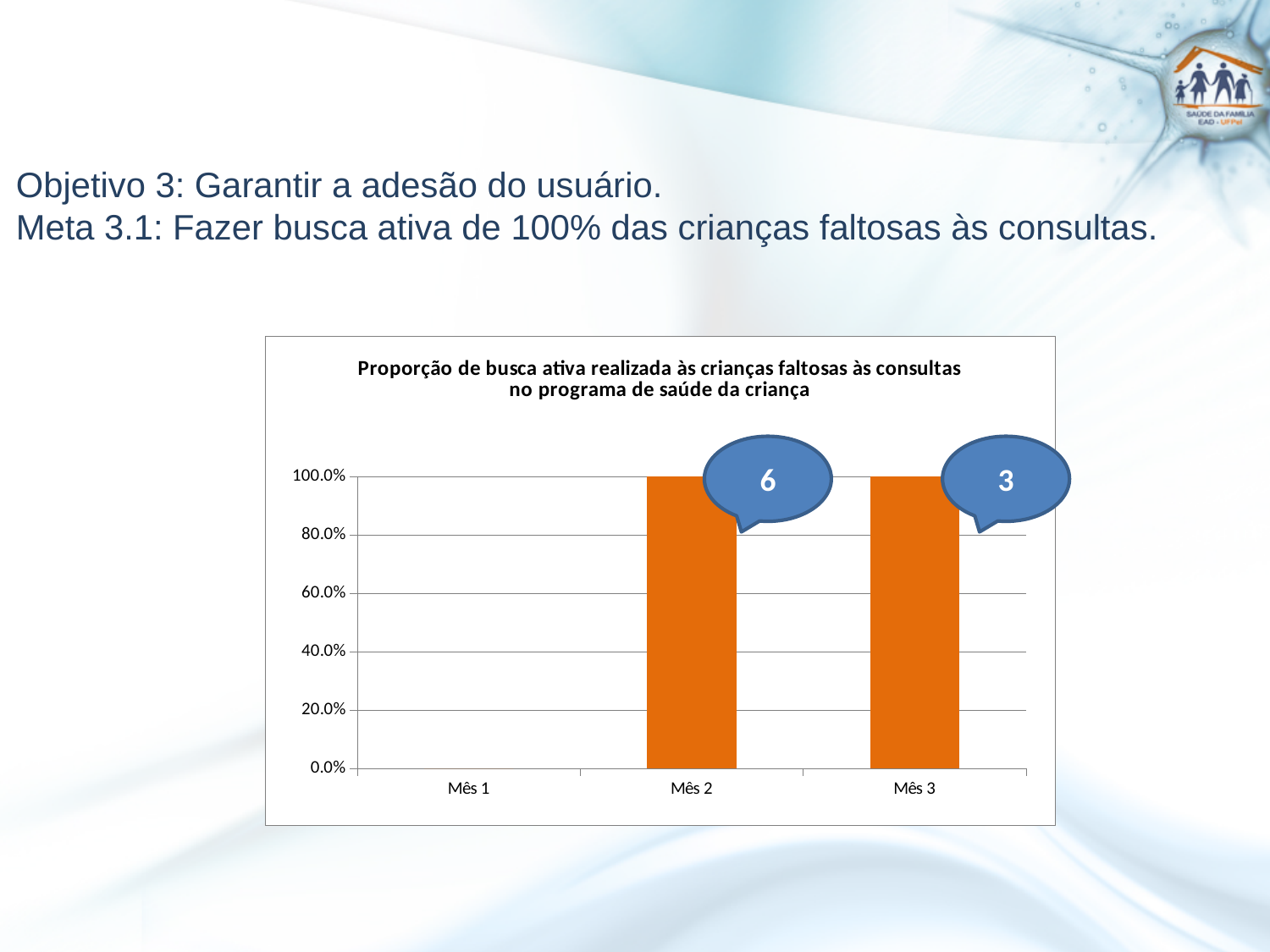
What is the value for Mês 2 in the chart? 100.0% Which month has the lowest value in the chart? Mês 1 Is the value for Mês 3 greater or less than 80.0%? greater Do the values rise or fall from Mês 1 to Mês 2? Rise What colour are the bars in the chart? Orange What number is shown in the callout next to the Mês 2 bar? 6 What is the difference between the value for Mês 3 and the value for Mês 1? 100.0% What is the value for Mês 3 in the chart? 100.0% What is the value for Mês 1 in the chart? 0.0% What type of chart is shown on the slide? Bar chart How many months (categories) are shown on the x axis of the chart? 3 Which is larger, the value for Mês 1 or the value for Mês 2? Mês 2